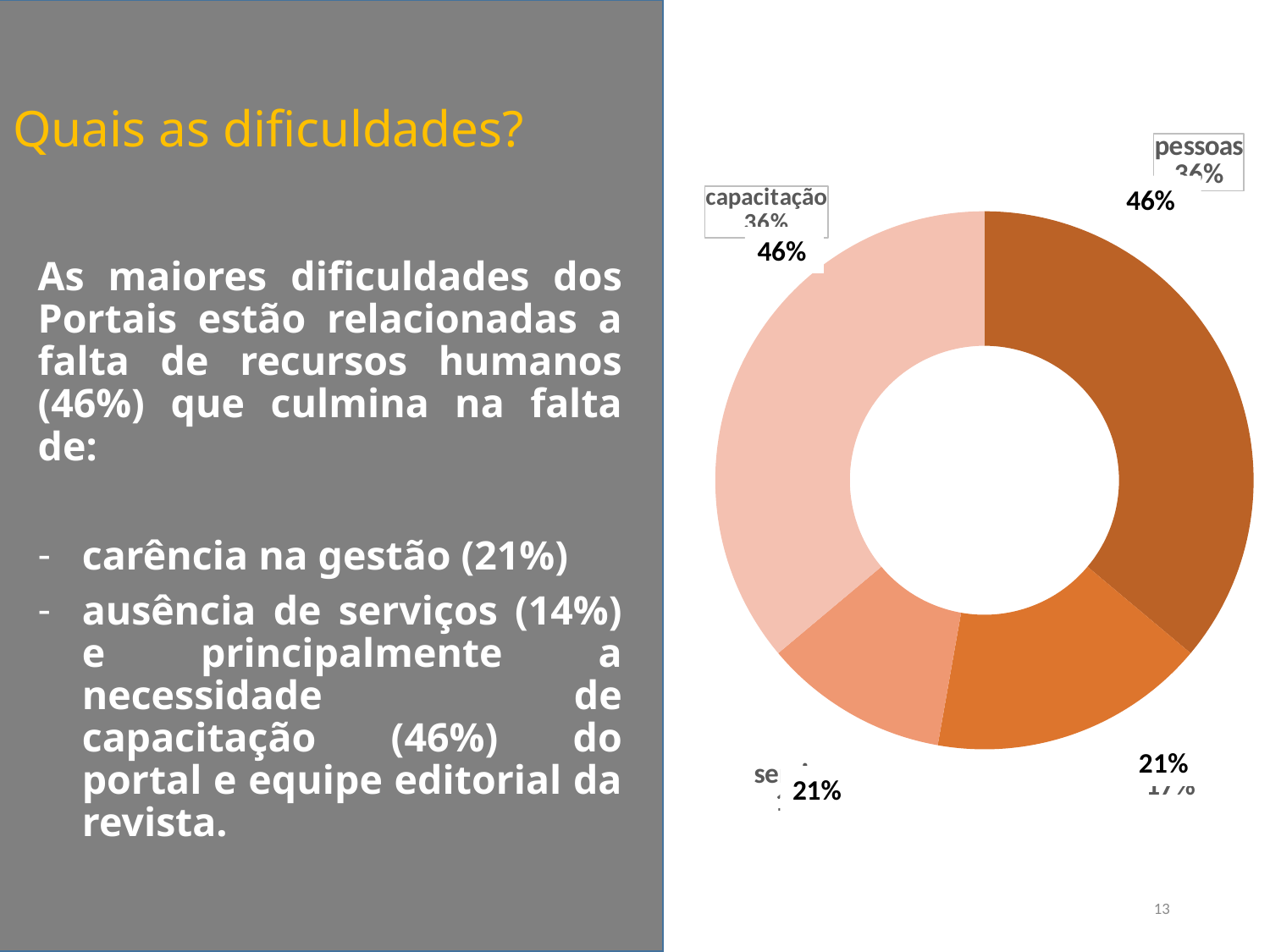
What colour is the 'capacitação' slice in the doughnut chart? Light pink What percentage is shown for the 'pessoas' slice? 46% What colour is the 'pessoas' slice in the doughnut chart? Dark orange What is the difference in percentage points between the 'pessoas' slice (46%) and the bottom-right slice (21%)? 25 percentage points Which is larger, the 'capacitação' slice or the bottom-left slice of the doughnut chart? capacitação What kind of chart is shown on the slide? Doughnut (pie) chart What percentage is shown for the 'capacitação' slice? 46% What percentage is shown for the slice at the bottom right of the doughnut chart? 21% Which is larger, the 'pessoas' slice or the bottom-right slice of the doughnut chart? pessoas How many slices does the doughnut chart have? 4 Is the 'pessoas' slice greater or less than 25% of the doughnut chart? greater